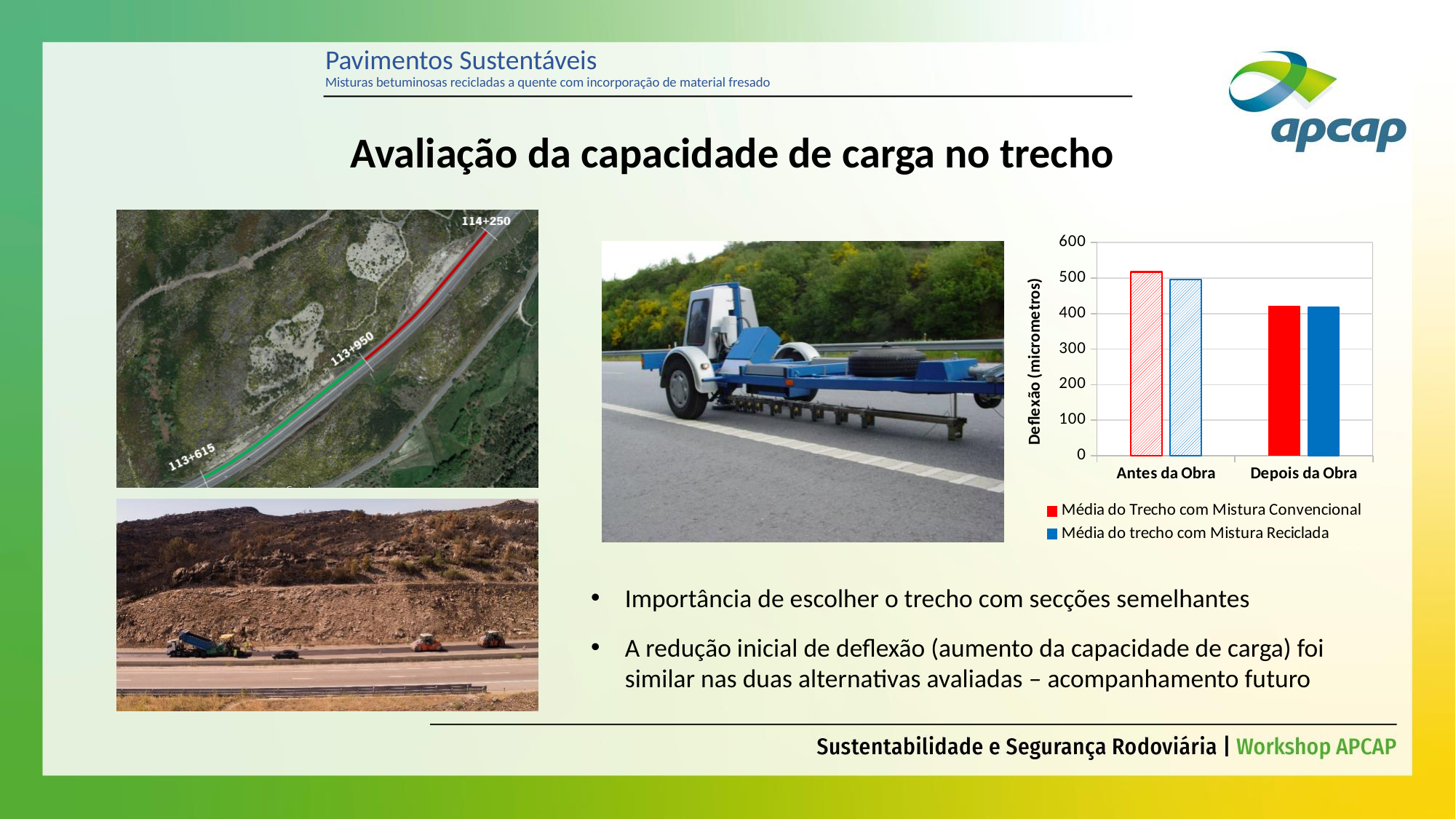
Is the value for Média do trecho com Mistura Reciclada at Antes da Obra greater or less than 400? greater Is the value for Média do Trecho com Mistura Convencional at Depois da Obra greater or less than 500? less Is the value for Média do trecho com Mistura Reciclada at Depois da Obra greater or less than 400? greater Which bar in the chart is the highest? Média do Trecho com Mistura Convencional, Antes da Obra How many categories are shown on the x axis of the chart? 2 Which series is shown in blue in the chart? Média do trecho com Mistura Reciclada What is the label of the chart's vertical axis? Deflexão (micrometros) How many series does the chart legend list? 2 Do the deflection values rise or fall from Antes da Obra to Depois da Obra? fall What kind of chart is shown on the slide? bar chart For Média do trecho com Mistura Reciclada, which is larger: the value at Antes da Obra or at Depois da Obra? Antes da Obra